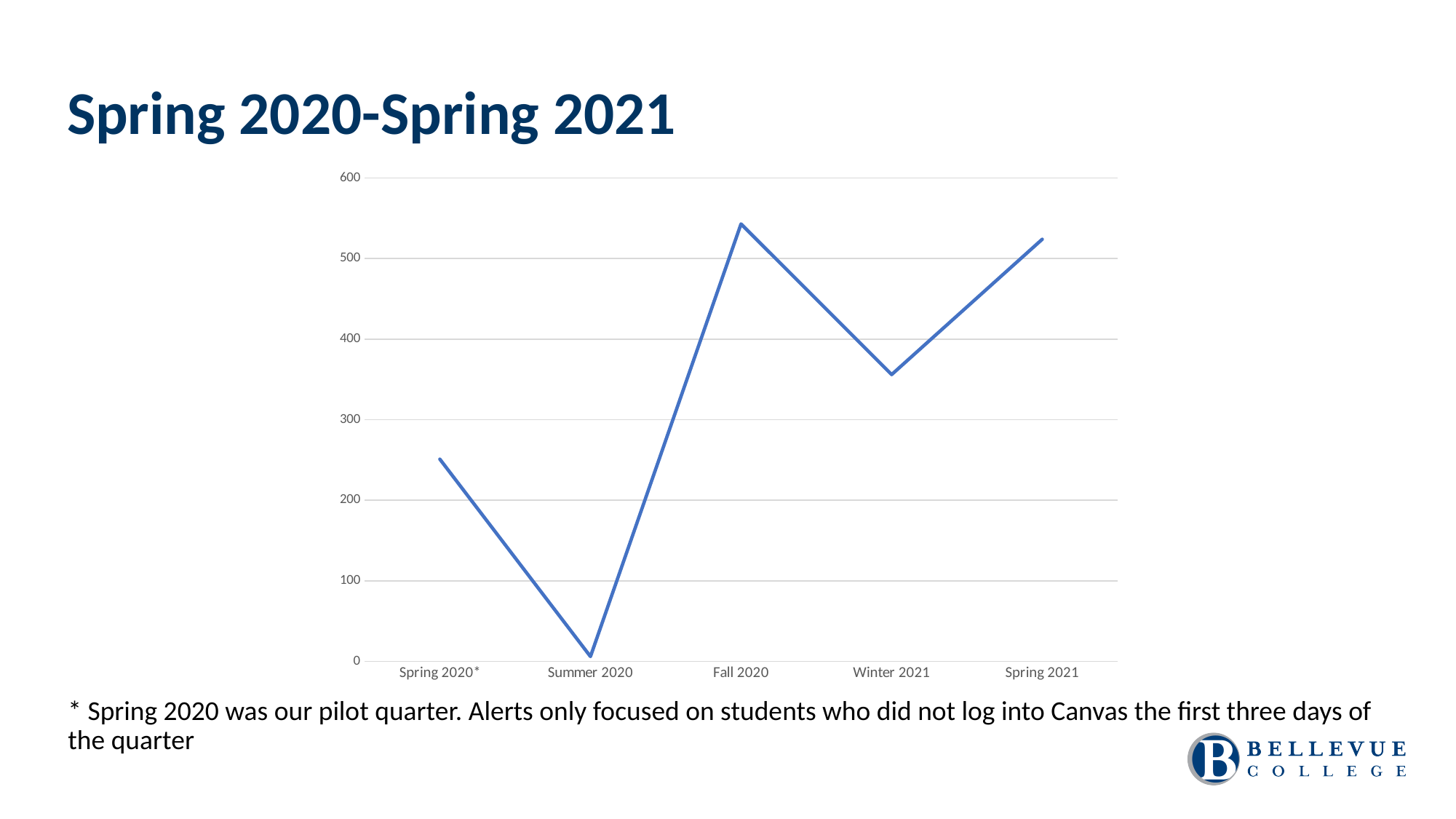
What is the title of the slide containing the chart? Spring 2020-Spring 2021 Is the value for Spring 2021 greater or less than 500? greater Which quarter has the highest value on the chart? Fall 2020 Is the value for Winter 2021 greater or less than 400? less Is the value for Fall 2020 greater or less than 500? greater How many quarters are plotted on the x axis of the chart? 5 What kind of chart is shown on the slide? line chart Does the line rise or fall from Fall 2020 to Winter 2021? fall Which has the larger value, Spring 2020* or Winter 2021? Winter 2021 Which quarter has the lowest value on the chart? Summer 2020